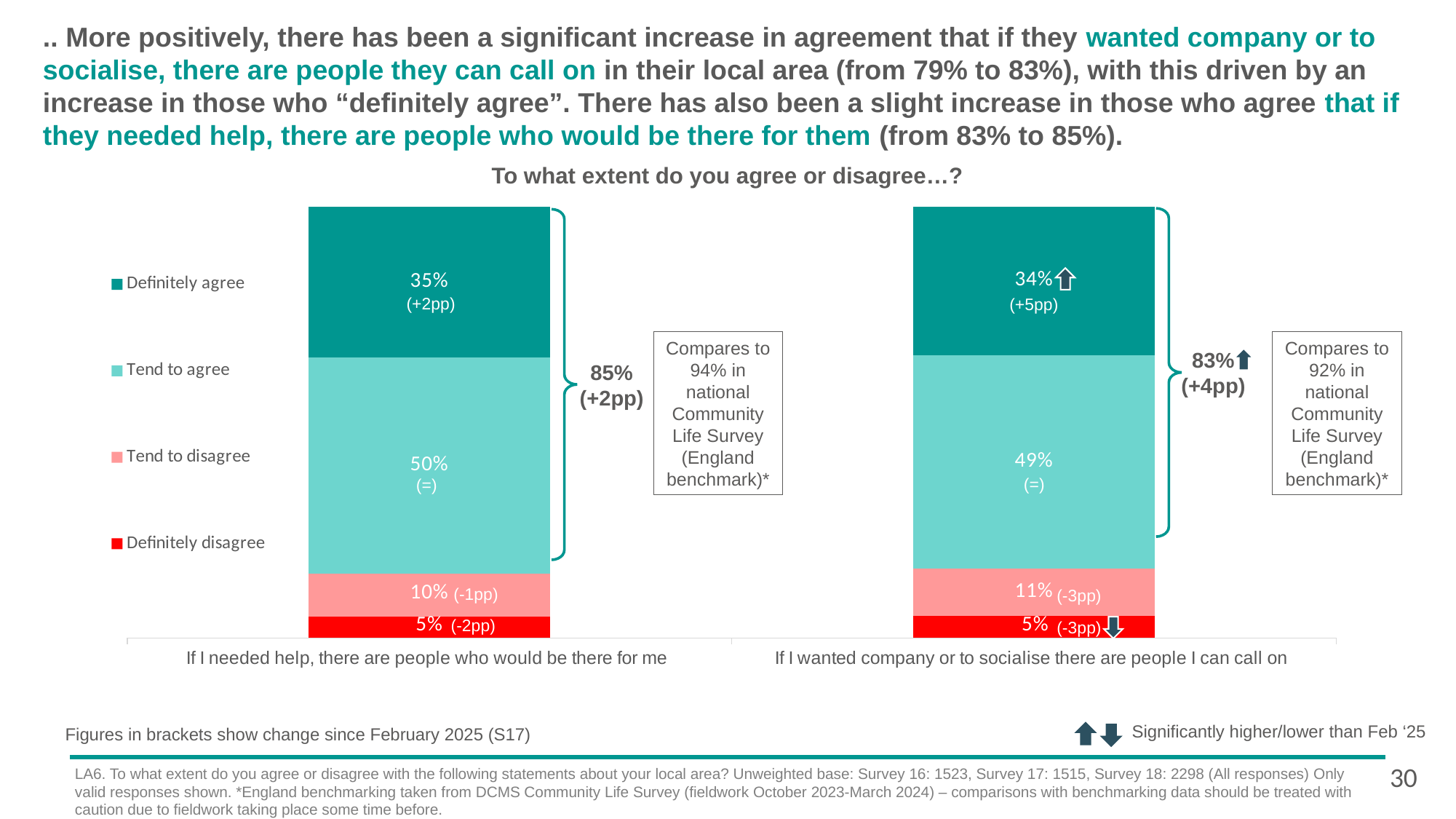
Which statement has the higher "definitely agree" percentage? If I needed help, there are people who would be there for me Which response segment is the largest for "If I needed help, there are people who would be there for me"? Tend to agree How many statements (bars) are plotted in the chart? 2 What percentage "definitely agree" with "If I needed help, there are people who would be there for me"? 35% What is the combined agreement (definitely agree plus tend to agree) for "If I needed help, there are people who would be there for me"? 85% What percentage "tend to disagree" with "If I wanted company or to socialise there are people I can call on"? 11% How many series does the legend list? 4 What is the change since February 2025 shown for "definitely agree" on "If I wanted company or to socialise there are people I can call on"? +5pp What percentage "tend to agree" with "If I wanted company or to socialise there are people I can call on"? 49% What kind of chart is shown on the slide? Stacked bar chart What is the difference between the "tend to agree" values for the two statements? 1 percentage point What England benchmark figure is given for "If I wanted company or to socialise there are people I can call on"? 92%